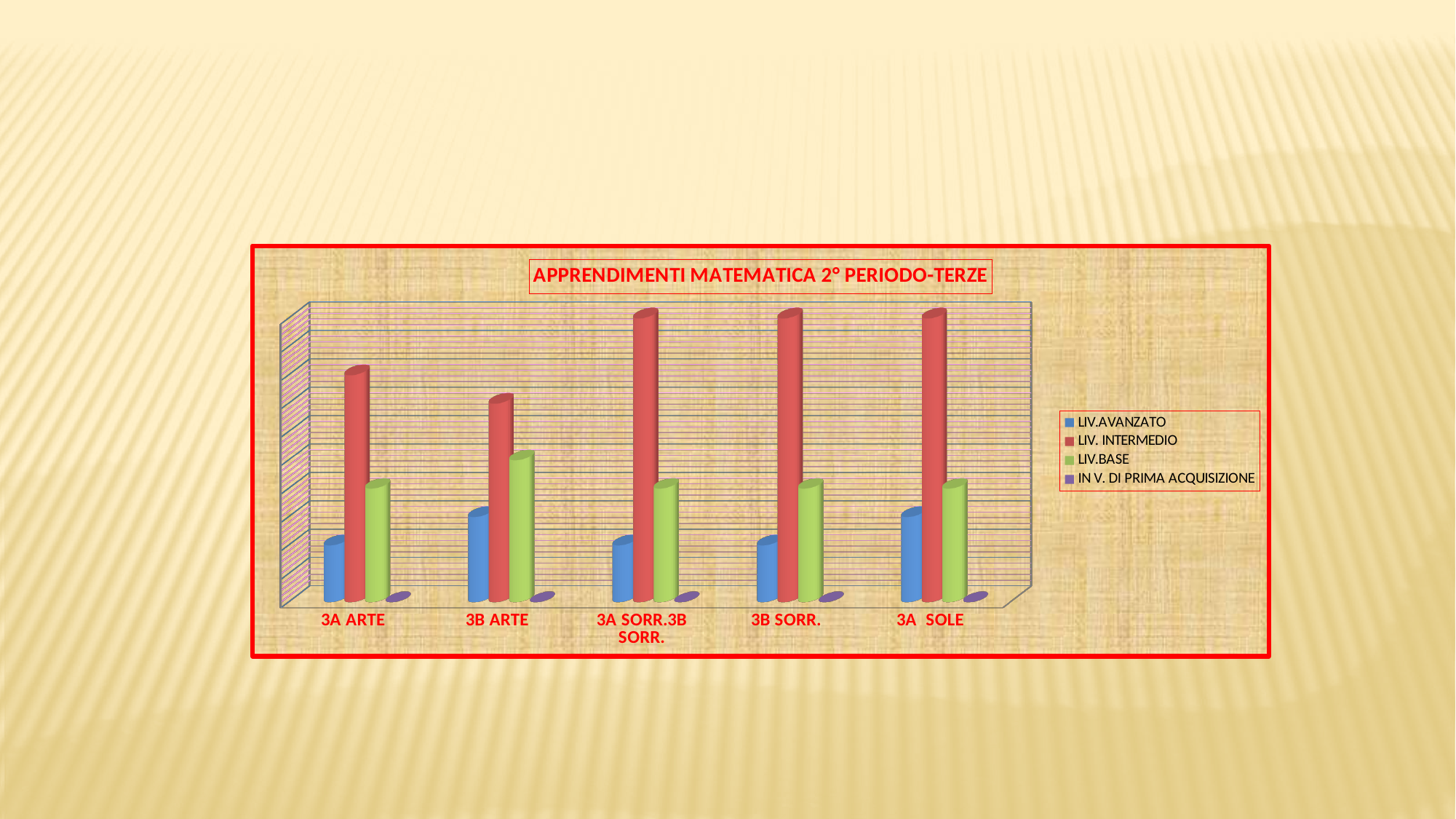
How many series does the legend list? 4 How many categories are shown on the x axis? 5 What is the title of the chart? APPRENDIMENTI MATEMATICA 2° PERIODO-TERZE Which category has the lowest LIV. INTERMEDIO value? 3B ARTE Which category has the highest LIV.BASE value? 3B ARTE Which series has the highest bar in the 3A ARTE category? LIV. INTERMEDIO Which series is represented by the red bars? LIV. INTERMEDIO Which is larger, the LIV.AVANZATO value for 3A ARTE or for 3B ARTE? 3B ARTE What kind of chart is shown on the slide? bar chart Which is larger, the LIV. INTERMEDIO value for 3A ARTE or for 3B ARTE? 3A ARTE Which series has the lowest value in the 3B ARTE category? IN V. DI PRIMA ACQUISIZIONE Which is larger, the LIV.BASE value for 3A ARTE or for 3B ARTE? 3B ARTE